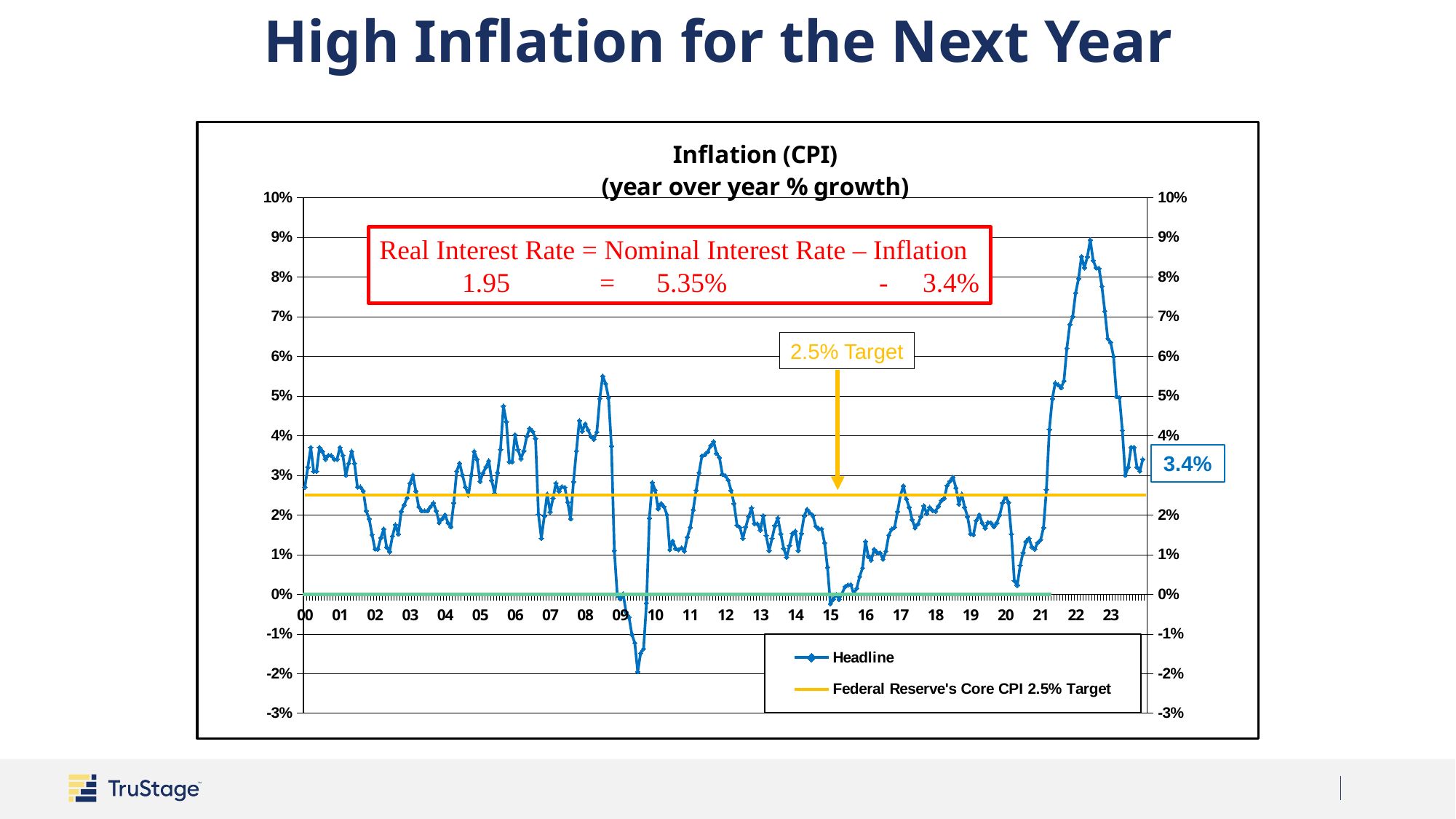
How many series does the legend list? 2 What are the two series named in the legend? Headline; Federal Reserve's Core CPI 2.5% Target What is the most recent Headline inflation value labeled on the chart? 3.4% What is the title of the chart? Inflation (CPI) (year over year % growth) Is the peak Headline inflation value in 2022 greater or less than 8%? greater What kind of chart is shown on the slide? line chart How many year labels are shown on the x axis? 24 From its 2022 peak to 2023, does the Headline inflation line rise or fall? fall Is the latest Headline inflation value of 3.4% above or below the 2.5% target line? above Is the lowest Headline inflation value in 2009 greater or less than -1%? less What is the Federal Reserve's Core CPI target shown on the chart? 2.5% Is the Headline inflation value in 2015 greater or less than 1%? less